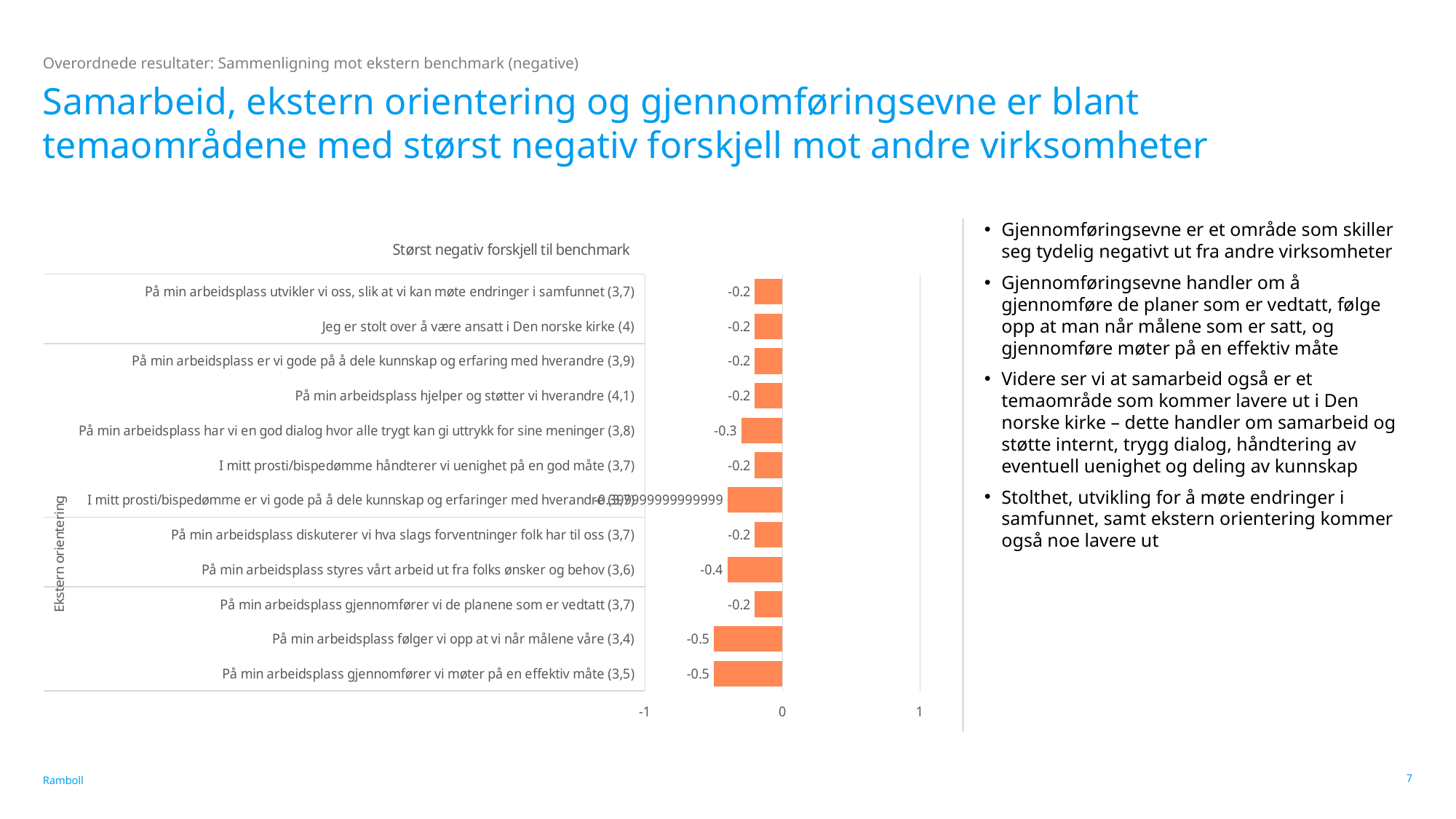
What is the title of the chart? Størst negativ forskjell til benchmark Which has the larger (less negative) value: "På min arbeidsplass styres vårt arbeid ut fra folks ønsker og behov (3,6)" or "På min arbeidsplass diskuterer vi hva slags forventninger folk har til oss (3,7)"? På min arbeidsplass diskuterer vi hva slags forventninger folk har til oss (3,7) What is the value for "På min arbeidsplass styres vårt arbeid ut fra folks ønsker og behov (3,6)"? -0.4 What kind of chart is shown on the slide? Bar chart What is the difference between the value for "På min arbeidsplass følger vi opp at vi når målene våre (3,4)" and the value for "På min arbeidsplass gjennomfører vi de planene som er vedtatt (3,7)"? 0.3 Is the value for "I mitt prosti/bispedømme er vi gode på å dele kunnskap og erfaringer med hverandre (3,7)" greater or less than 0? less What is the value for "På min arbeidsplass har vi en god dialog hvor alle trygt kan gi uttrykk for sine meninger (3,8)"? -0.3 What is the value for "På min arbeidsplass gjennomfører vi møter på en effektiv måte (3,5)"? -0.5 What is the value for "Jeg er stolt over å være ansatt i Den norske kirke (4)"? -0.2 What is the value for "På min arbeidsplass følger vi opp at vi når målene våre (3,4)"? -0.5 How many categories (statements) are plotted in the chart? 12 What are the minimum and maximum tick values shown on the horizontal axis? -1 and 1